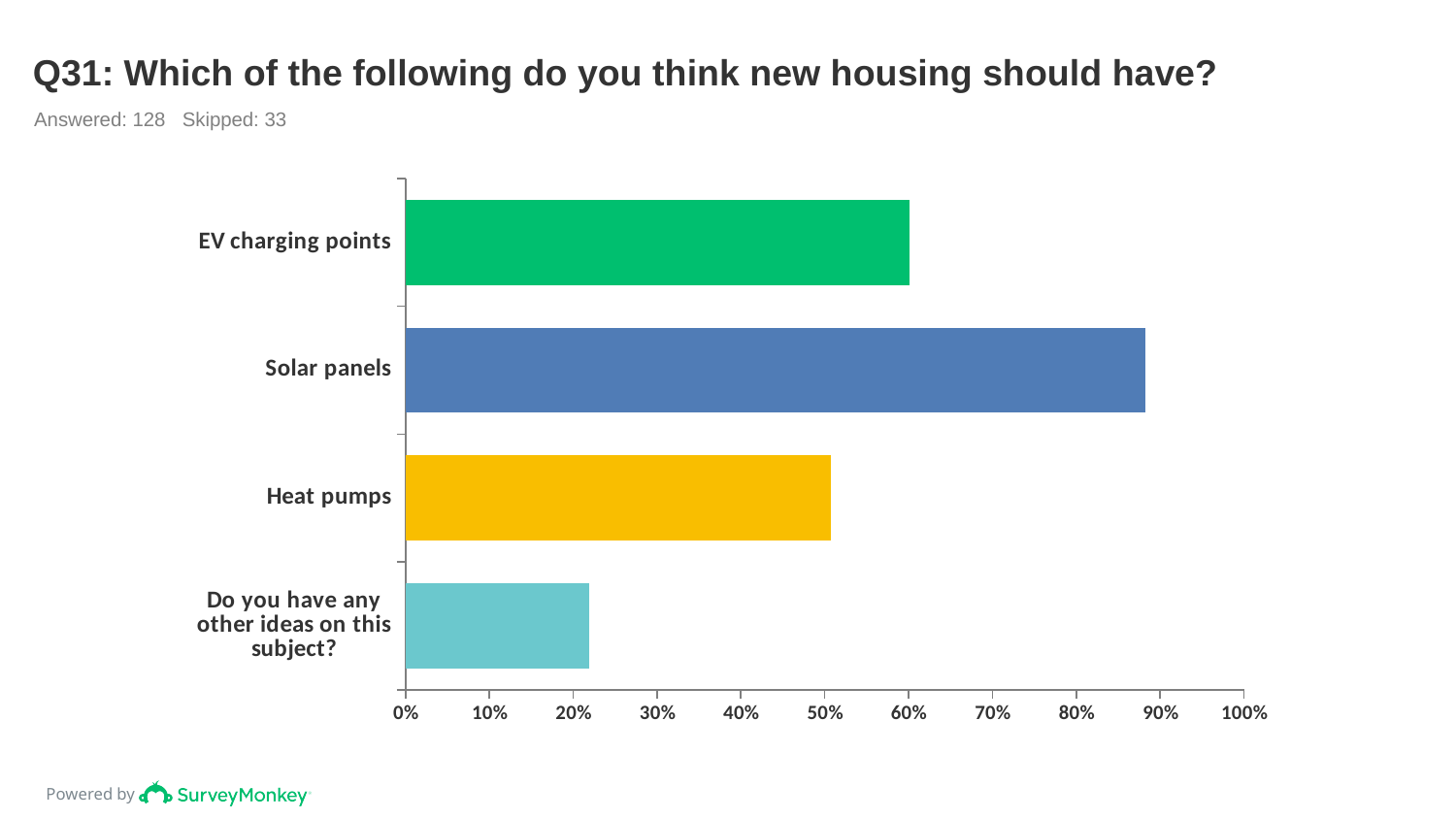
Which is larger, the value for Solar panels or the value for EV charging points? Solar panels Which category has the lowest value? Do you have any other ideas on this subject? Which category has the highest value? Solar panels Which is larger, the value for EV charging points or the value for Heat pumps? EV charging points How many respondents answered the question according to the slide? 128 Is the value for Solar panels greater or less than 80%? greater Is the value for EV charging points greater or less than 70%? less Is the value for "Do you have any other ideas on this subject?" greater or less than 30%? less What is the title of the chart? Q31: Which of the following do you think new housing should have? How many categories are plotted in the chart? 4 What kind of chart is shown on the slide? bar chart